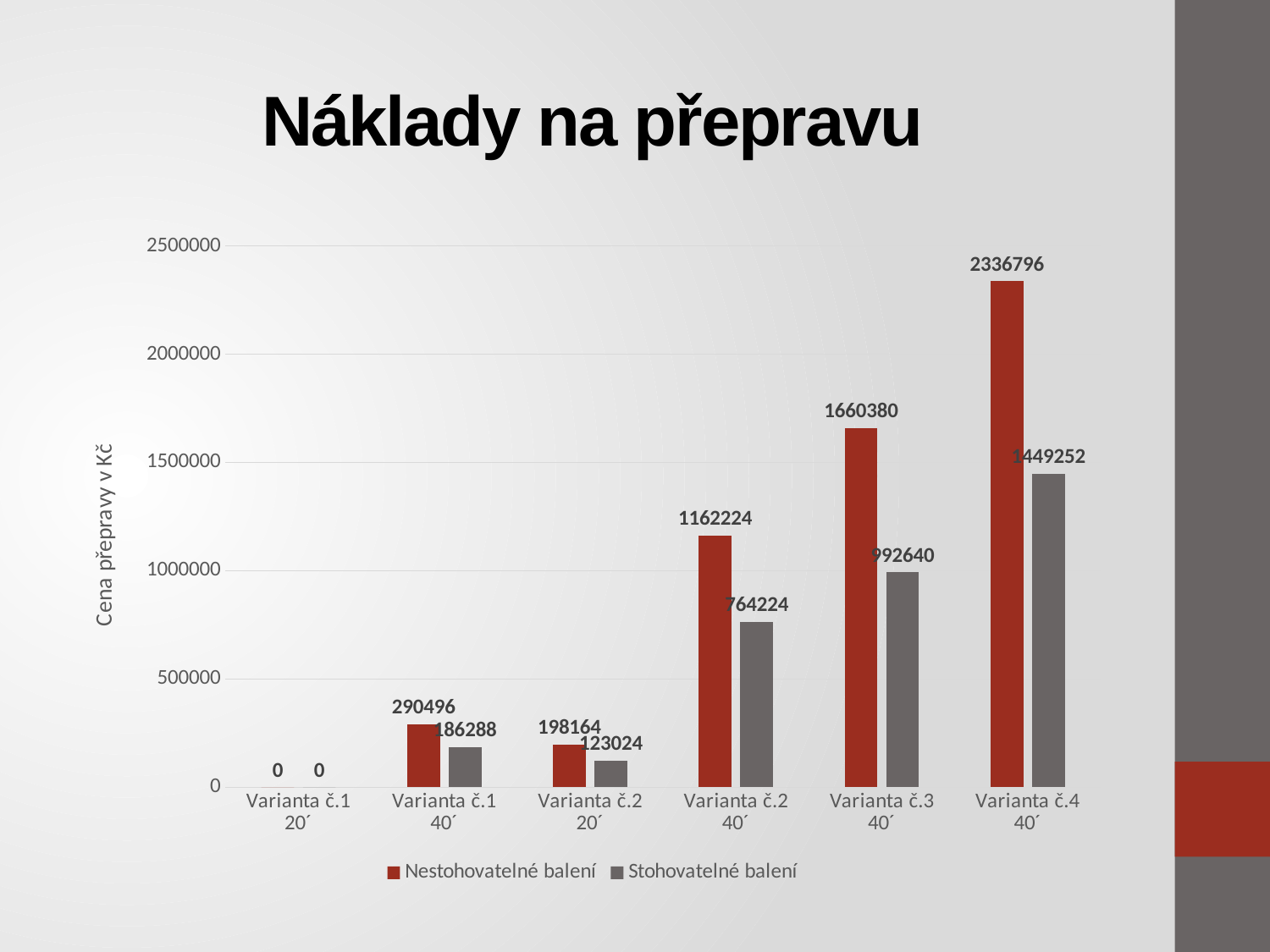
Which category has the highest value for Stohovatelné balení? Varianta č.4 40´ Which category has the lowest value for Nestohovatelné balení? Varianta č.1 20´ What type of chart is shown on the slide? bar chart What is the difference between Nestohovatelné balení and Stohovatelné balení for Varianta č.4 40´? 887544 How many categories are shown on the x axis? 6 What is the title of the chart? Náklady na přepravu Which is larger for Varianta č.2 40´: Nestohovatelné balení or Stohovatelné balení? Nestohovatelné balení What is the value for Stohovatelné balení for Varianta č.2 40´? 764224 How many series does the legend list? 2 What is the value for Nestohovatelné balení for Varianta č.2 20´? 198164 What is the value for Nestohovatelné balení for Varianta č.4 40´? 2336796 What is the difference between Nestohovatelné balení and Stohovatelné balení for Varianta č.3 40´? 667740